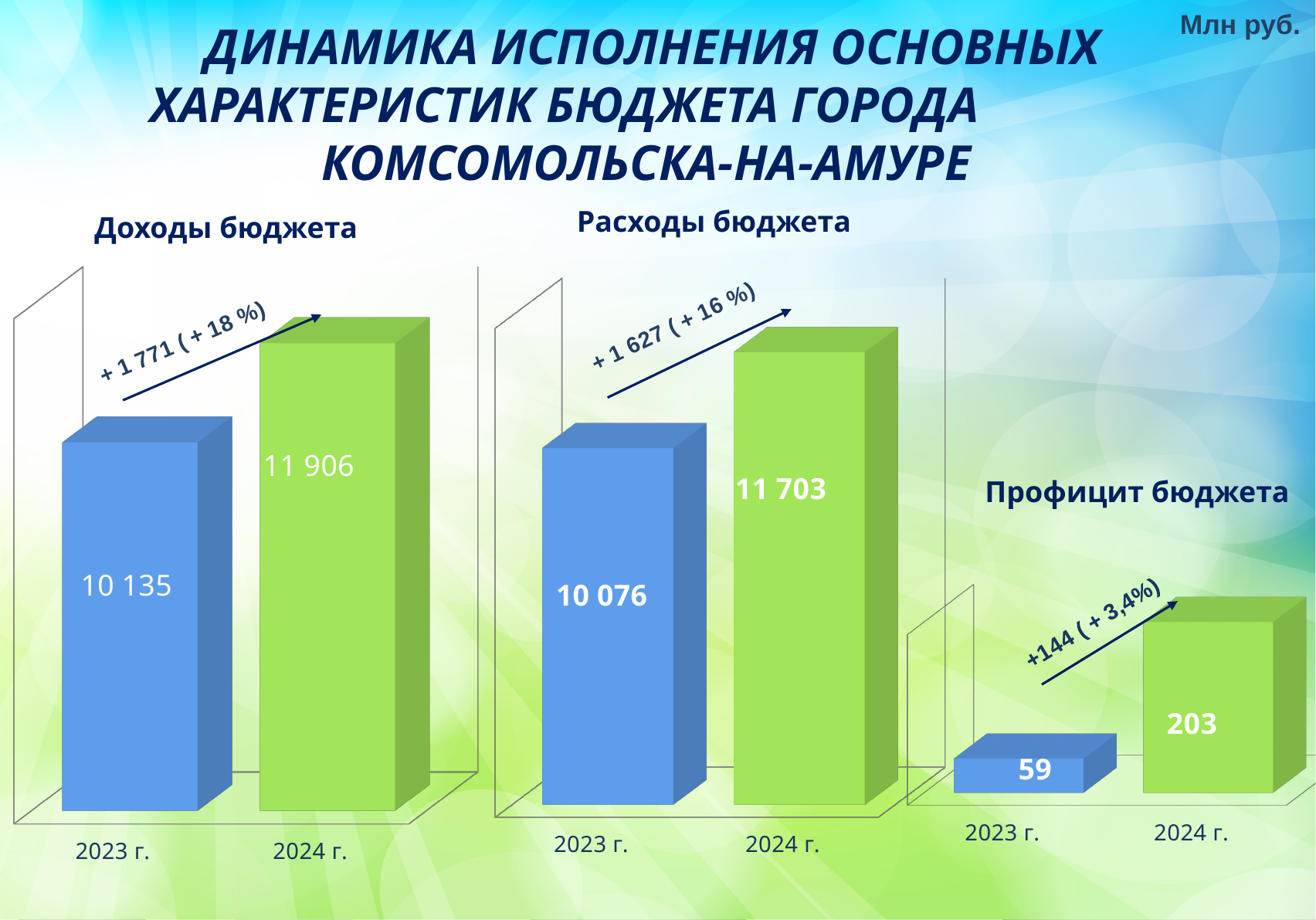
In the 'Доходы бюджета' chart, which year has the higher value? 2024 г. In the 'Доходы бюджета' chart, what is the value for 2024 г.? 11 906 What kind of chart is the 'Доходы бюджета' chart? bar chart In the 'Расходы бюджета' chart, which year has the lower value? 2023 г. In the 'Расходы бюджета' chart, what is the value for 2024 г.? 11 703 In the 'Профицит бюджета' chart, what is the value for 2024 г.? 203 In the 'Расходы бюджета' chart, what is the difference between the 2024 г. and 2023 г. values? 1 627 In the 'Доходы бюджета' chart, what is the value for 2023 г.? 10 135 In the 'Профицит бюджета' chart, what is the difference between the 2024 г. and 2023 г. values? 144 How many categories does the 'Расходы бюджета' chart show? 2 In the 'Профицит бюджета' chart, is the value for 2023 г. larger or smaller than the value for 2024 г.? smaller In the 'Профицит бюджета' chart, what is the value for 2023 г.? 59